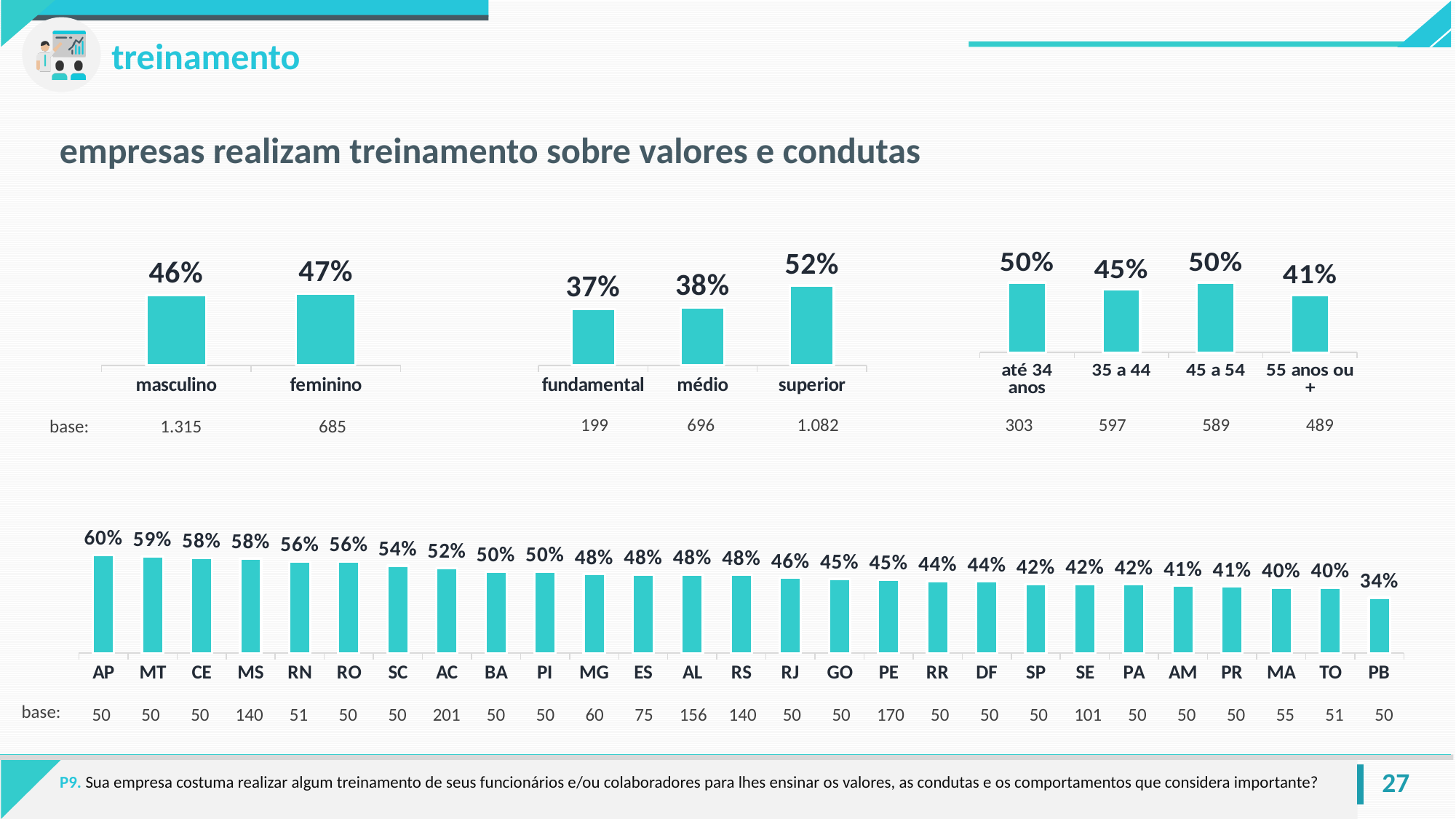
In the education chart (top middle), which category has the lowest value? fundamental In the age chart (top right), what is the difference between the values for 35 a 44 and 55 anos ou +? 4% In the gender chart (top left), what is the value for feminino? 47% In the states chart (bottom), which state has the lowest value? PB In the states chart (bottom), which state has the highest value? AP In the age chart (top right), how many age categories are shown? 4 In the age chart (top right), what is the value for 55 anos ou +? 41% What type of chart is the states chart at the bottom of the slide? bar chart In the states chart (bottom), what is the value for MG? 48% In the states chart (bottom), how many states are shown? 27 In the education chart (top middle), what is the value for superior? 52% In the states chart (bottom), which is larger, the value for SC or the value for GO? SC